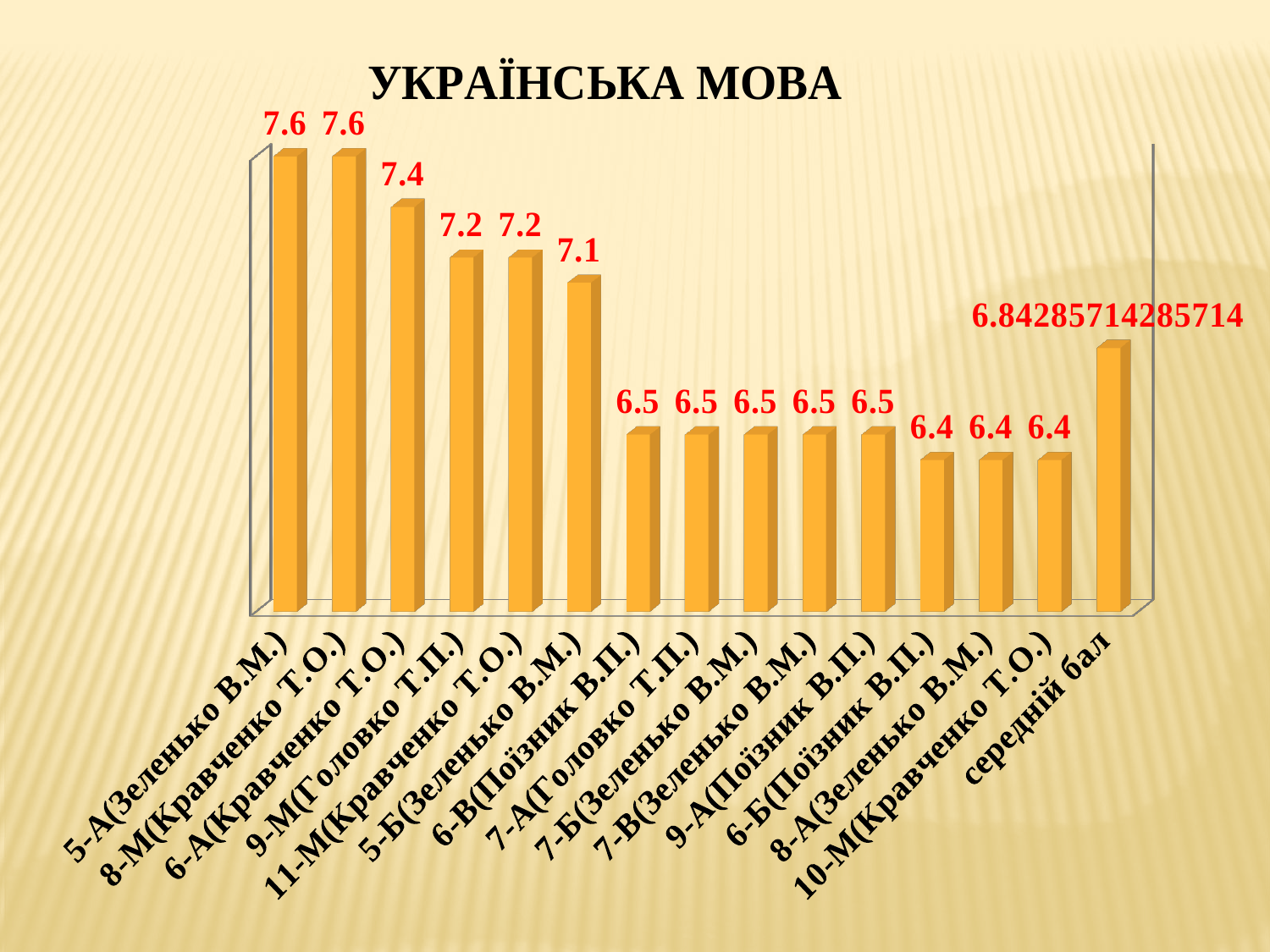
What is the difference between the values for 5-А(Зеленько В.М.) and 10-М(Кравченко Т.О.)? 1.2 What is the highest value shown in the chart? 7.6 What is the value shown for середній бал? 6.84285714285714 Which has a larger value, 6-А(Кравченко Т.О.) or 6-В(Поїзник В.П.)? 6-А(Кравченко Т.О.) What is the difference between the values for 11-М(Кравченко Т.О.) and 8-А(Зеленько В.М.)? 0.8 What type of chart is shown on the slide? bar chart How many bars (categories) does the chart show? 15 What is the value for 6-А(Кравченко Т.О.)? 7.4 What is the value for 5-Б(Зеленько В.М.)? 7.1 What is the title of the chart? УКРАЇНСЬКА МОВА What is the lowest value shown in the chart? 6.4 What is the value for 9-М(Головко Т.П.)? 7.2